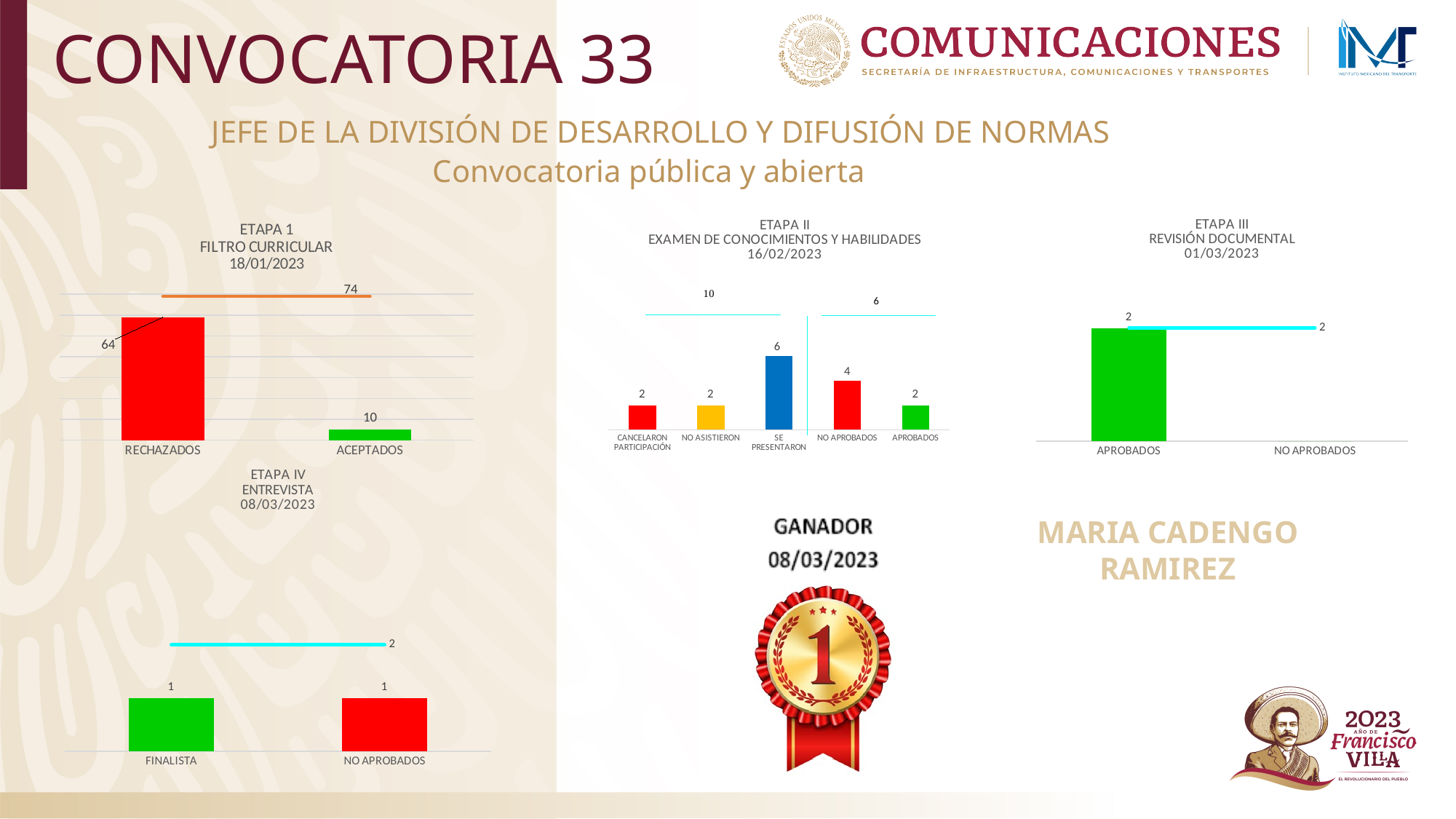
What kind of chart is the ETAPA IV ENTREVISTA chart? Combination bar and line chart In the ETAPA IV ENTREVISTA chart, what is the value for FINALISTA? 1 In the ETAPA 1 FILTRO CURRICULAR chart, what is the value for ACEPTADOS? 10 In the ETAPA II EXAMEN DE CONOCIMIENTOS Y HABILIDADES chart, what is the value for NO APROBADOS? 4 In the ETAPA III REVISIÓN DOCUMENTAL chart, what is the value for APROBADOS? 2 In the ETAPA II EXAMEN DE CONOCIMIENTOS Y HABILIDADES chart, which category has the highest bar? SE PRESENTARON In the ETAPA 1 FILTRO CURRICULAR chart, what is the value for RECHAZADOS? 64 In the ETAPA 1 FILTRO CURRICULAR chart, what is the difference between RECHAZADOS and ACEPTADOS? 54 In the ETAPA II EXAMEN DE CONOCIMIENTOS Y HABILIDADES chart, what is the value for SE PRESENTARON? 6 In the ETAPA II EXAMEN DE CONOCIMIENTOS Y HABILIDADES chart, how many bar categories are shown? 5 In the ETAPA II EXAMEN DE CONOCIMIENTOS Y HABILIDADES chart, which is larger, NO APROBADOS or APROBADOS? NO APROBADOS In the ETAPA 1 FILTRO CURRICULAR chart, what value is labelled on the orange line? 74